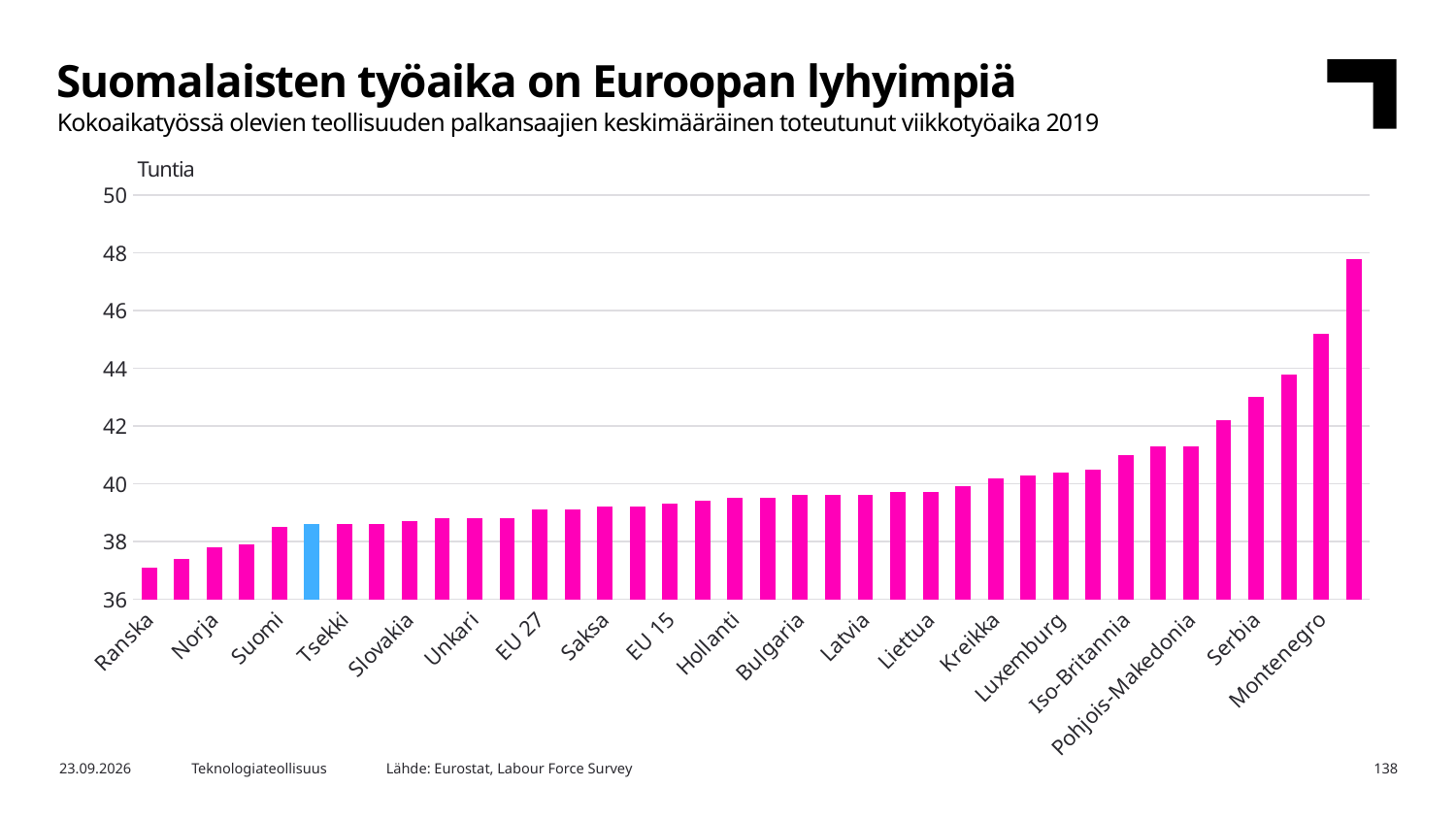
What unit is shown on the vertical axis of the chart? Tuntia Is the value for Saksa greater or less than 40? less Is the value for Serbia greater or less than 42? greater Is the value for Ranska greater or less than 38? less Do the bar values rise or fall from left to right along the x axis? rise Which country has the lowest average weekly working time in the chart? Ranska Which is larger, the value for Montenegro or the value for Serbia? Montenegro What kind of chart is shown on the slide? bar chart Which is larger, the value for Saksa or the value for Suomi? Saksa